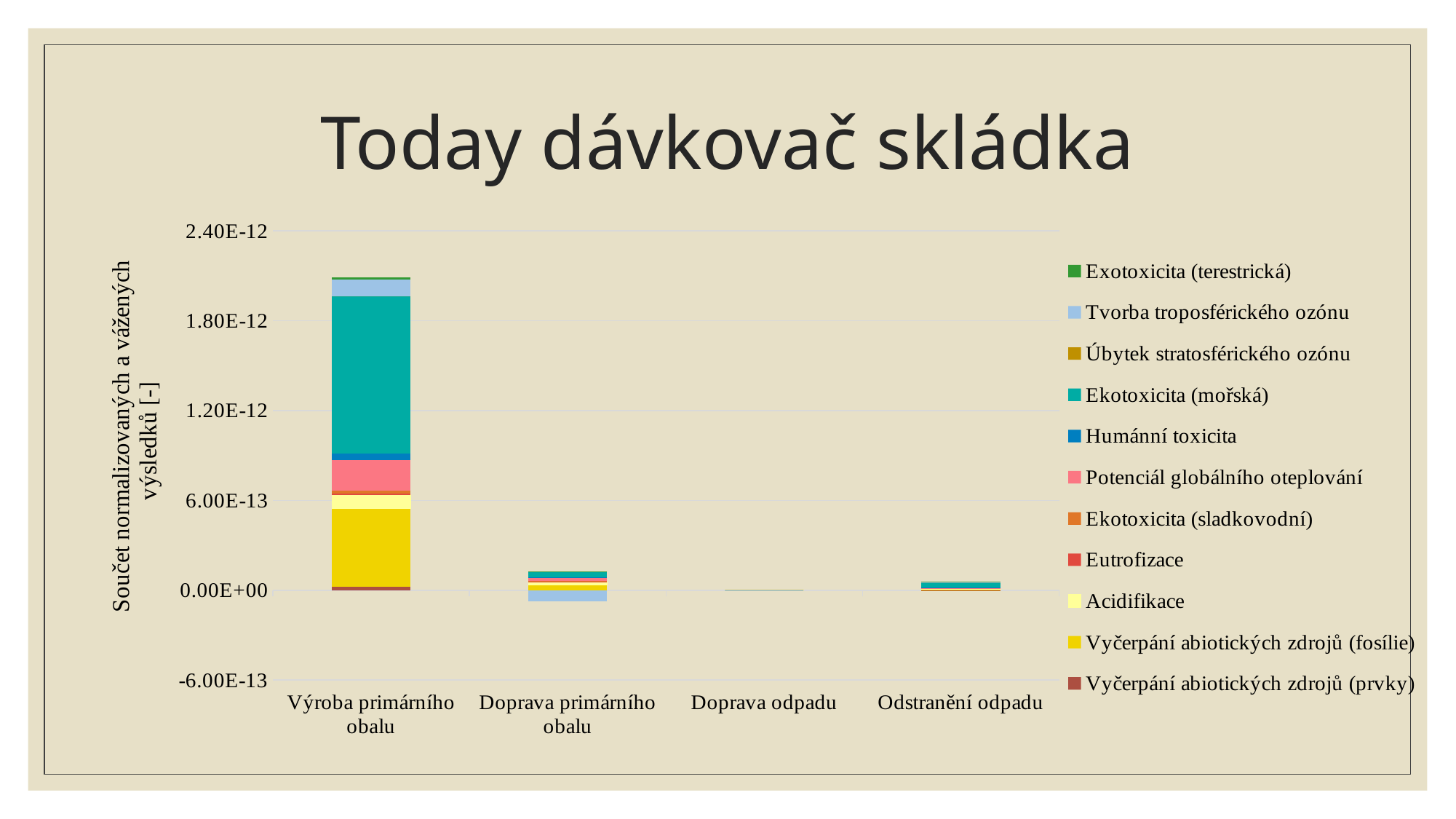
What is the title of the slide? Today dávkovač skládka Which stacked bar is taller: Výroba primárního obalu or Doprava primárního obalu? Výroba primárního obalu Which category has the tallest stacked bar? Výroba primárního obalu How many series does the chart's legend list? 11 Is the top of the stacked bar for Výroba primárního obalu greater or less than 1.80E-12? greater How many categories are shown on the x axis of the chart? 4 Is the top of the stacked bar for Výroba primárního obalu greater or less than 2.40E-12? less What kind of chart is shown on the slide? stacked bar chart Is the top of the stacked bar for Doprava primárního obalu greater or less than 6.00E-13? less Which series is shown in yellow in the legend? Vyčerpání abiotických zdrojů (fosílie) Which stacked bar is taller: Odstranění odpadu or Doprava odpadu? Odstranění odpadu